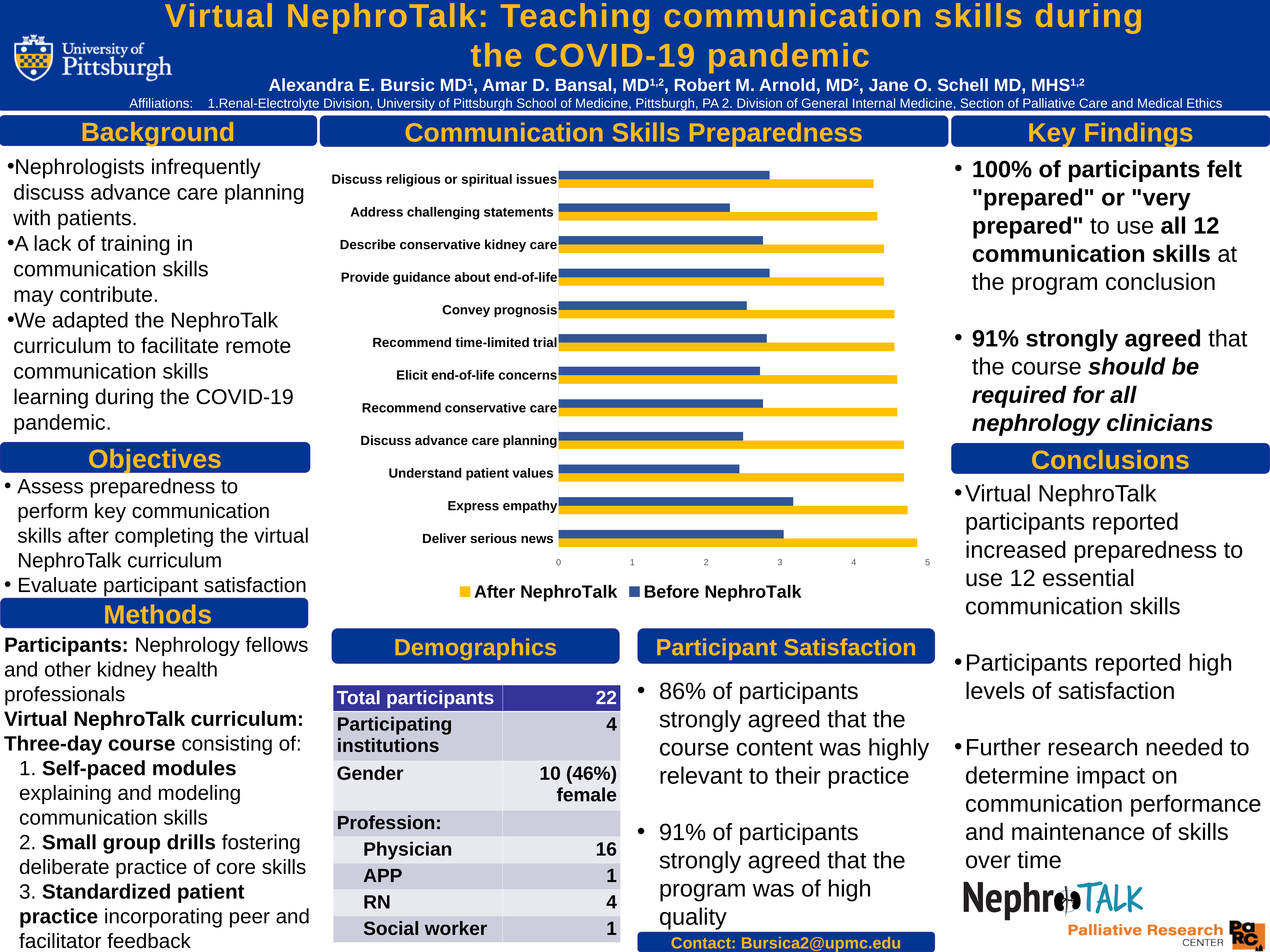
In the Communication Skills Preparedness chart, which skill has the highest Before NephroTalk value? Express empathy What kind of chart is shown under the heading "Communication Skills Preparedness"? bar chart In the Communication Skills Preparedness chart, which series is shown in yellow? After NephroTalk How many series does the legend of the Communication Skills Preparedness chart list? 2 In the Communication Skills Preparedness chart, is the Before NephroTalk value for Address challenging statements greater or less than 3? less In the Communication Skills Preparedness chart, is the Before NephroTalk value for Express empathy greater or less than 3? greater How many communication skills (categories) are plotted in the Communication Skills Preparedness chart? 12 In the Communication Skills Preparedness chart, which skill has the lowest Before NephroTalk value? Address challenging statements In the Communication Skills Preparedness chart, which skill has the highest After NephroTalk value? Deliver serious news In the Communication Skills Preparedness chart, is the After NephroTalk value for Deliver serious news greater or less than 4? greater In the Communication Skills Preparedness chart, for Convey prognosis, which is larger: the After NephroTalk value or the Before NephroTalk value? After NephroTalk What is the maximum value shown on the horizontal axis of the Communication Skills Preparedness chart? 5